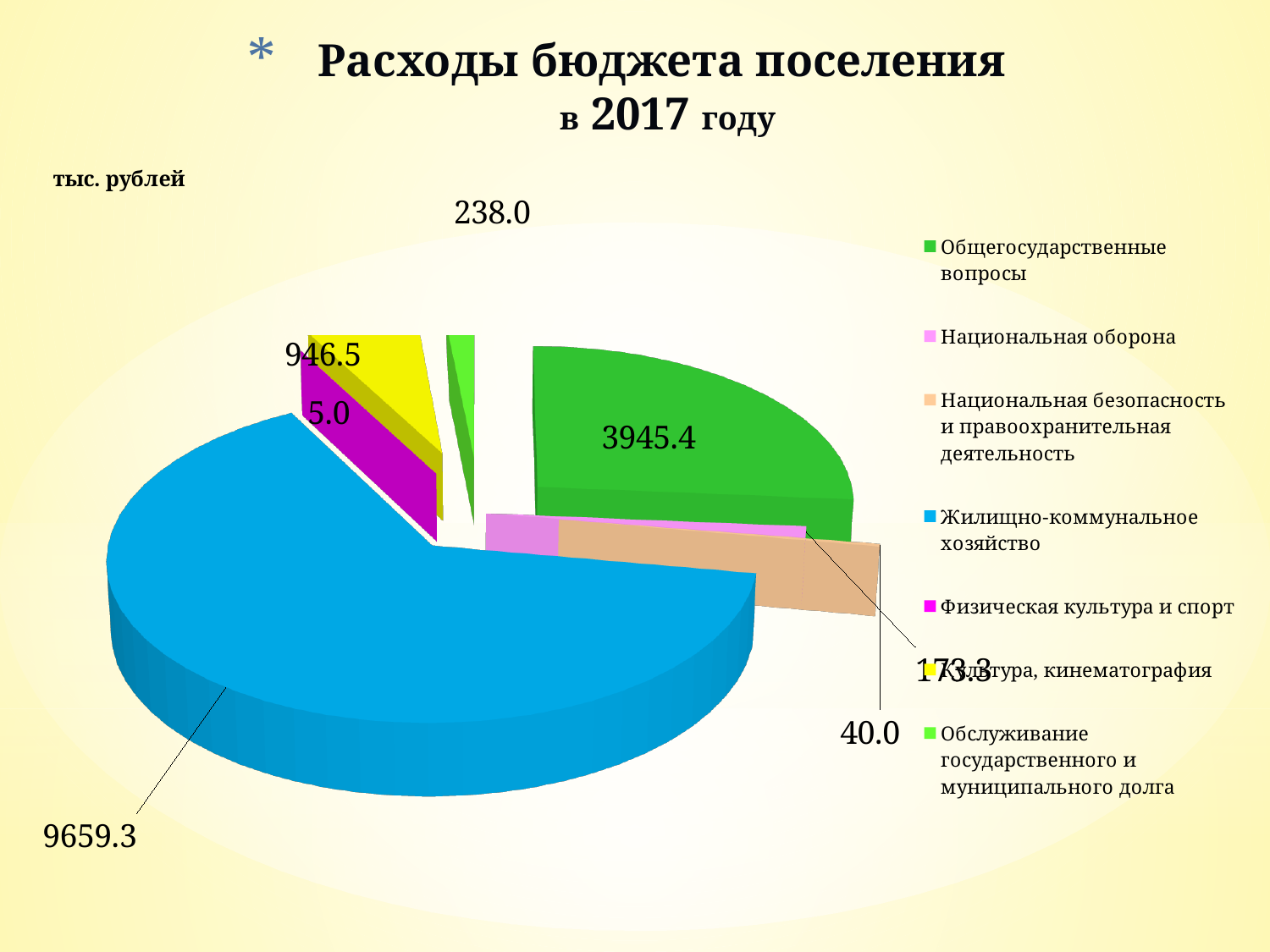
What is the value for Общегосударственные вопросы? 3945.4 Which category has the smallest value? Физическая культура и спорт How many entries does the legend list? 7 What is the difference between the values for Жилищно-коммунальное хозяйство and Общегосударственные вопросы? 5713.9 What is the value for Культура, кинематография? 946.5 In what units are the values on the chart given? тыс. рублей Which category has the largest share of the pie? Жилищно-коммунальное хозяйство What kind of chart is shown on the slide? Pie chart What is the value for Жилищно-коммунальное хозяйство? 9659.3 What is the value for Физическая культура и спорт? 5.0 What is the value for Обслуживание государственного и муниципального долга? 238.0 How many categories does the pie chart show? 7